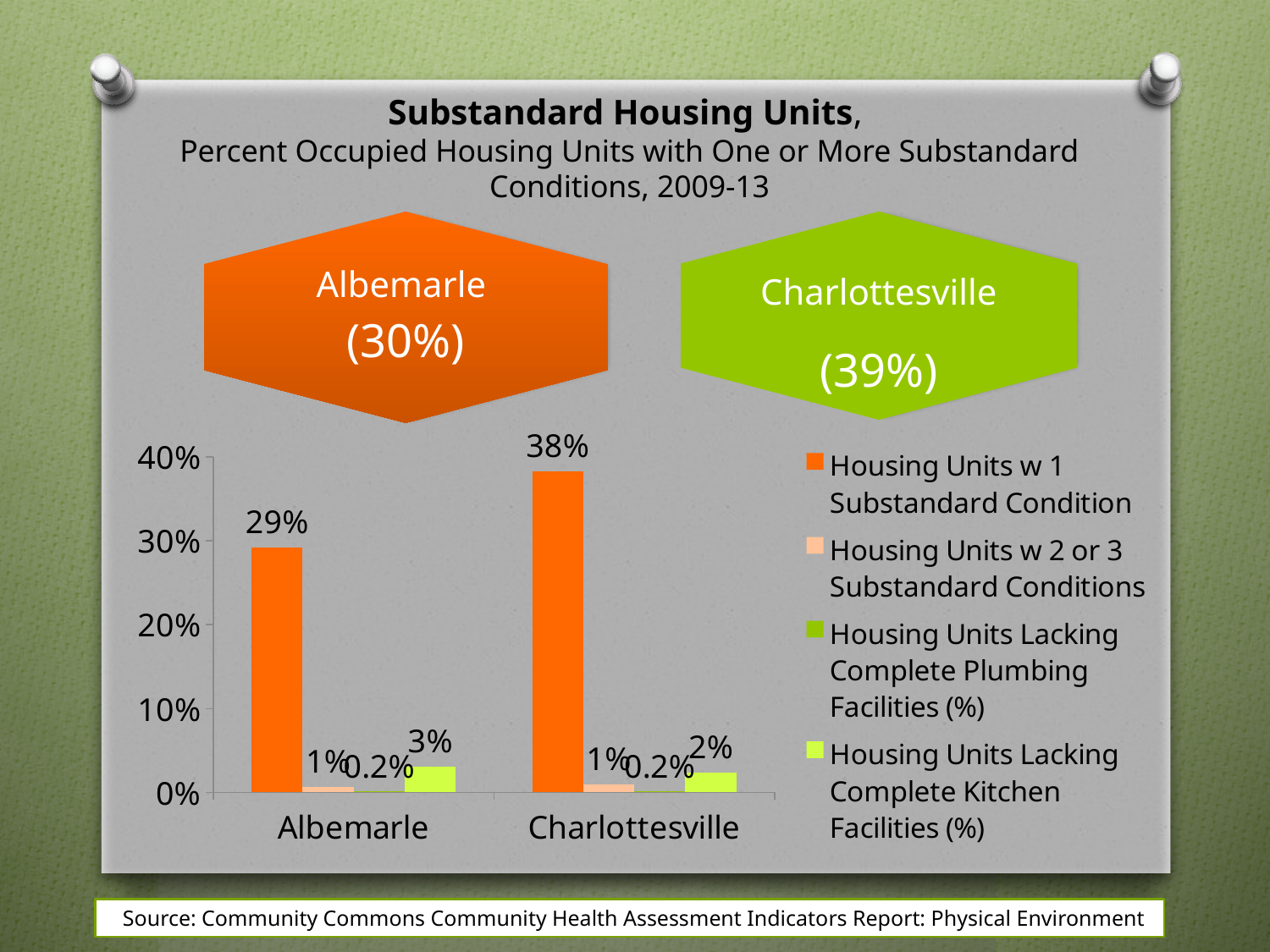
What is the value for Housing Units Lacking Complete Plumbing Facilities (%) in Charlottesville? 0.2% What is the value for Housing Units Lacking Complete Kitchen Facilities (%) in Albemarle? 3% What is the value for Housing Units w 1 Substandard Condition in Albemarle? 29% What is the difference between Charlottesville and Albemarle for Housing Units w 1 Substandard Condition? 9% What is the value for Housing Units w 1 Substandard Condition in Charlottesville? 38% Which category has the higher value for Housing Units w 1 Substandard Condition? Charlottesville Which is larger: Housing Units Lacking Complete Kitchen Facilities in Albemarle or in Charlottesville? Albemarle How many categories are shown on the x axis? 2 What colour represents Housing Units w 1 Substandard Condition in the legend? Orange Is the value for Housing Units w 1 Substandard Condition in Albemarle greater or less than 20%? greater What kind of chart is shown on the slide? Bar chart How many series does the legend list? 4